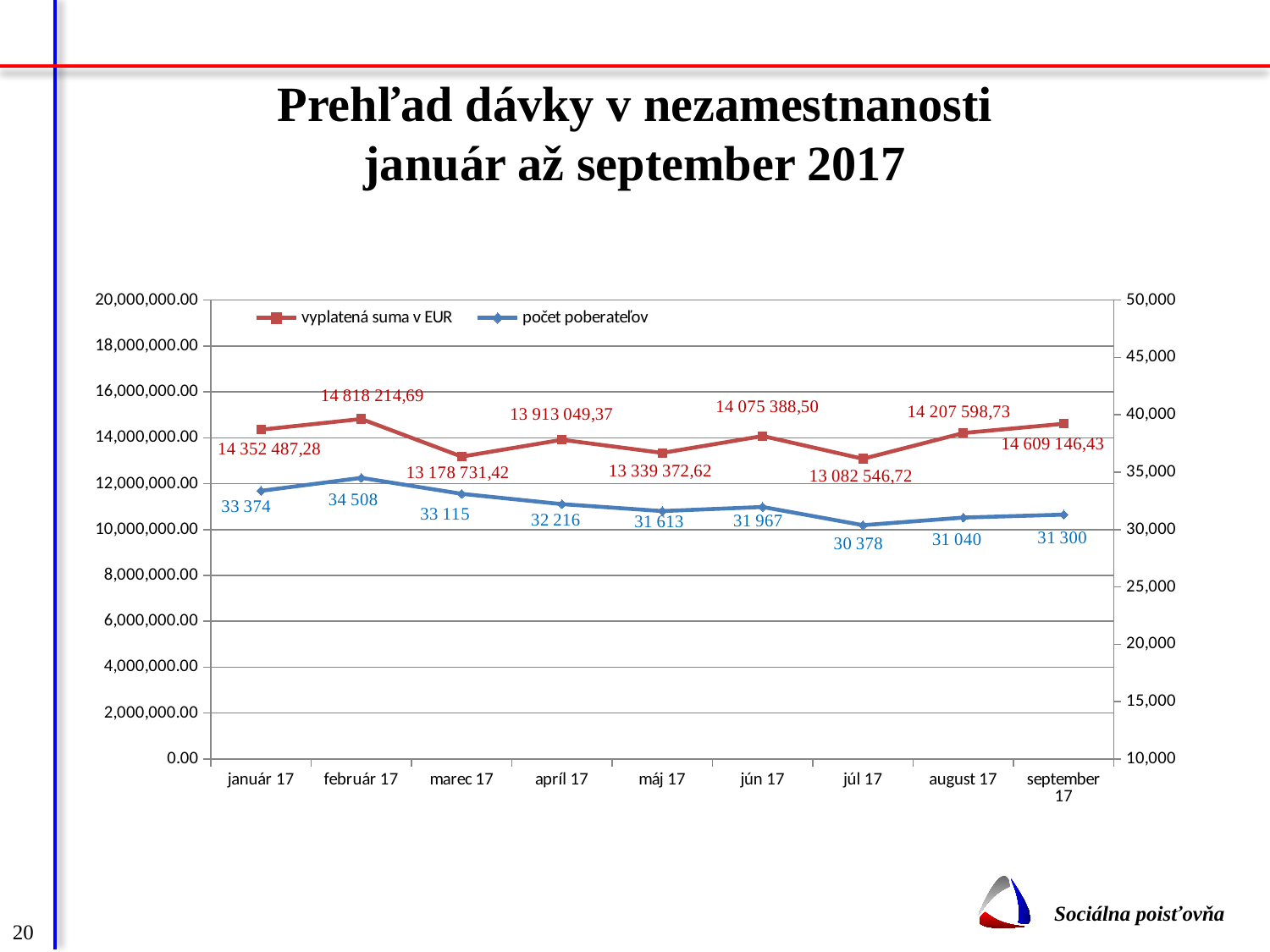
What is the difference in počet poberateľov between február 17 and január 17? 1 134 How many series does the legend list? 2 What is the počet poberateľov for máj 17? 31 613 What type of chart is shown on the slide? line chart What colour is the line for vyplatená suma v EUR? red In which month is vyplatená suma v EUR the highest? február 17 What is the difference in vyplatená suma v EUR between august 17 and júl 17? 1 125 052,01 In which month is počet poberateľov the lowest? júl 17 How many months are plotted along the x axis? 9 Which month has a larger vyplatená suma v EUR, apríl 17 or jún 17? jún 17 Does počet poberateľov rise or fall from február 17 to júl 17? fall What is the value of vyplatená suma v EUR for marec 17? 13 178 731,42